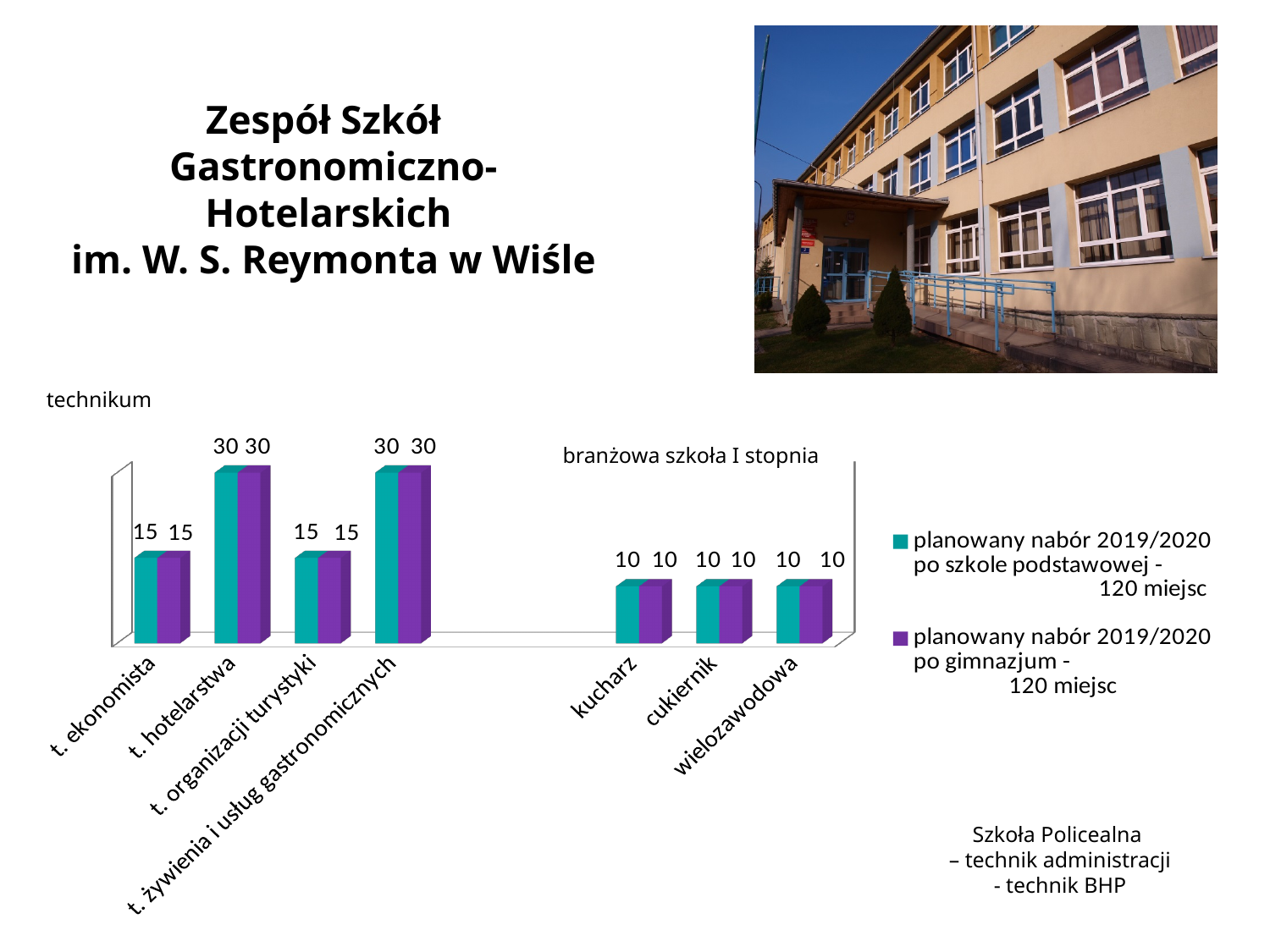
What colour are the bars for the 'planowany nabór 2019/2020 po gimnazjum' series? purple Which category has the lowest value in the 'planowany nabór 2019/2020 po szkole podstawowej' series among the technikum categories? t. ekonomista and t. organizacji turystyki (15 each) What is the value for t. żywienia i usług gastronomicznych in the 'planowany nabór 2019/2020 po gimnazjum' series? 30 What is the value for kucharz in the 'planowany nabór 2019/2020 po gimnazjum' series? 10 What kind of chart is shown on the slide? bar chart What is the difference between the 'po szkole podstawowej' values for t. hotelarstwa and t. organizacji turystyki? 15 How many labeled categories are shown on the x axis of the chart? 7 What is the value for t. hotelarstwa in the 'planowany nabór 2019/2020 po szkole podstawowej' series? 30 How many series does the legend list? 2 What is the value for t. ekonomista in the 'planowany nabór 2019/2020 po szkole podstawowej' series? 15 Which is larger: the 'po szkole podstawowej' value for t. żywienia i usług gastronomicznych or for wielozawodowa? t. żywienia i usług gastronomicznych What is the difference between the 'po gimnazjum' values for t. ekonomista and cukiernik? 5